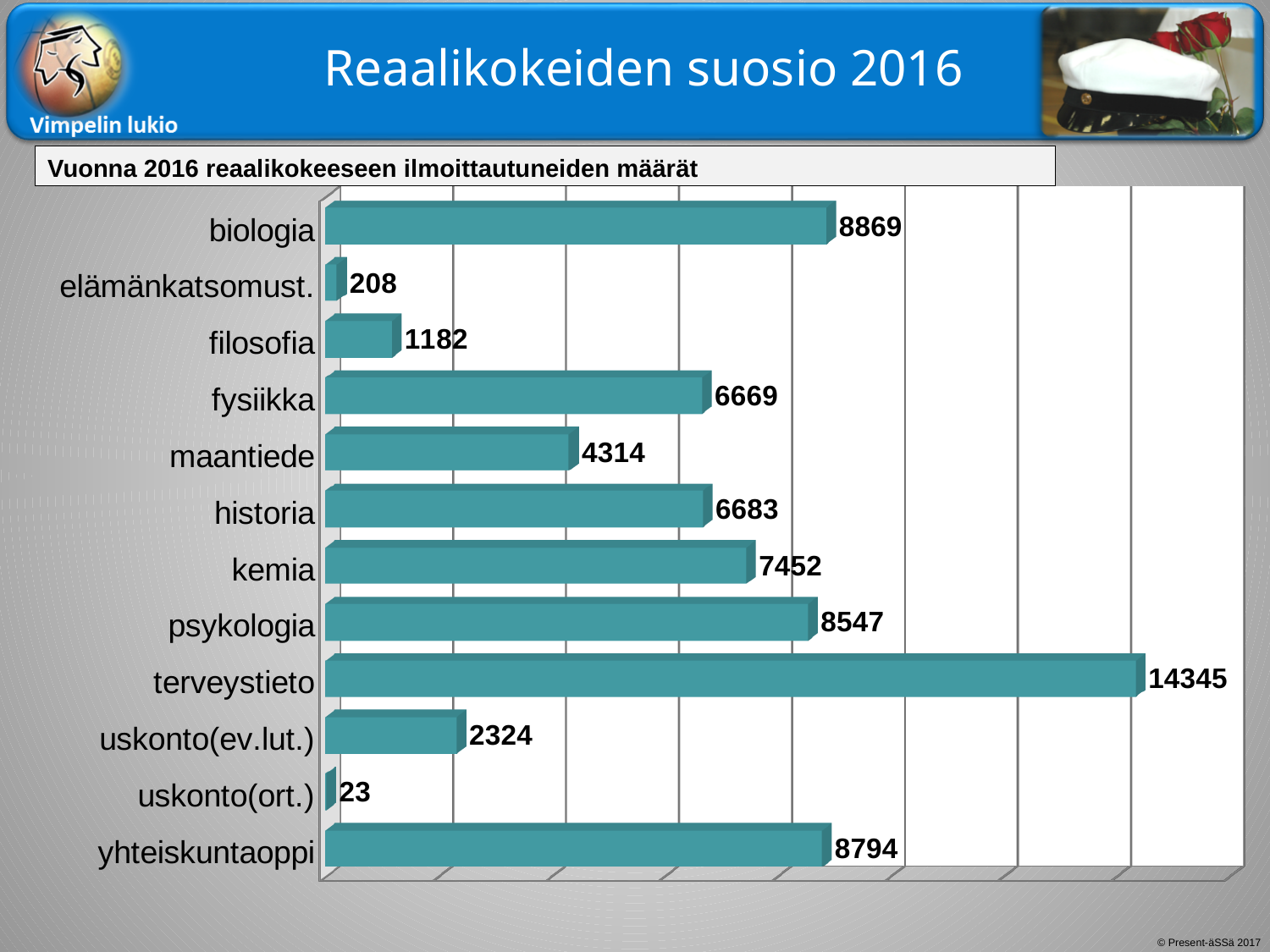
What is the value for biologia? 8869 Which is larger, the value for psykologia or the value for yhteiskuntaoppi? yhteiskuntaoppi Which is larger, the value for filosofia or the value for uskonto(ev.lut.)? uskonto(ev.lut.) What kind of chart is shown on the slide? bar chart Which category has the highest value? terveystieto What is the difference between the values for kemia and fysiikka? 783 What is the title of the chart? Vuonna 2016 reaalikokeeseen ilmoittautuneiden määrät Which category has the lowest value? uskonto(ort.) What is the difference between the values for terveystieto and biologia? 5476 How many categories are shown in the chart? 12 What is the value for terveystieto? 14345 What is the value for uskonto(ev.lut.)? 2324